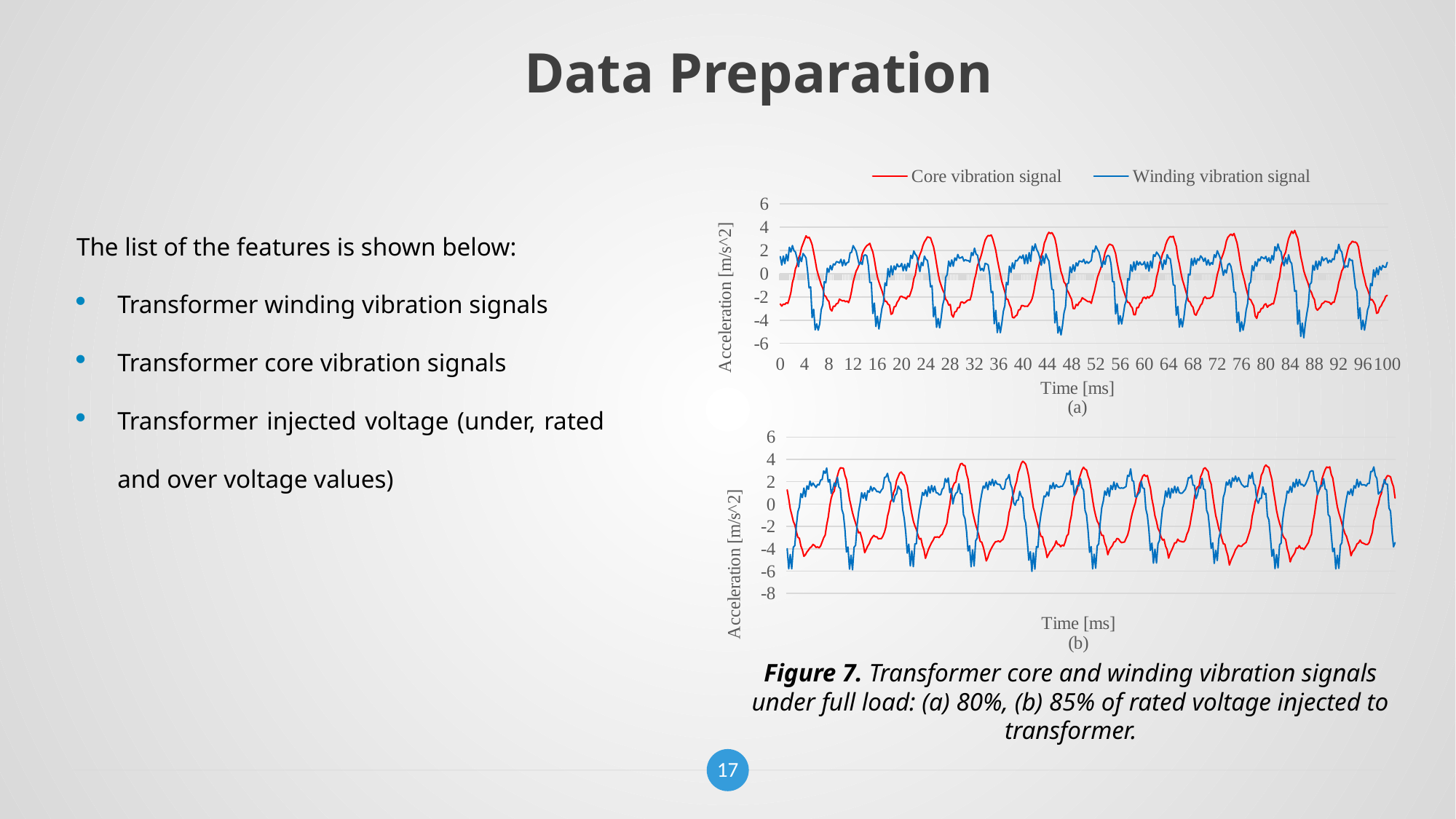
In chart (b), which series reaches the higher peak value, the Core vibration signal or the Winding vibration signal? Core vibration signal What kind of chart is chart (b) on the slide? Line chart In chart (b), is the highest value of the Winding vibration signal greater or less than 4? less In chart (a), is the lowest value of the Winding vibration signal greater or less than -4? less In chart (a), what is the label of the y axis? Acceleration [m/s^2] In chart (b), is the lowest value of the Winding vibration signal greater or less than -4? less How many series does the legend above chart (a) list? 2 In chart (a), which series reaches the lower minimum value, the Core vibration signal or the Winding vibration signal? Winding vibration signal In chart (a), which series is drawn in red? Core vibration signal What kind of chart is chart (a) on the slide? Line chart